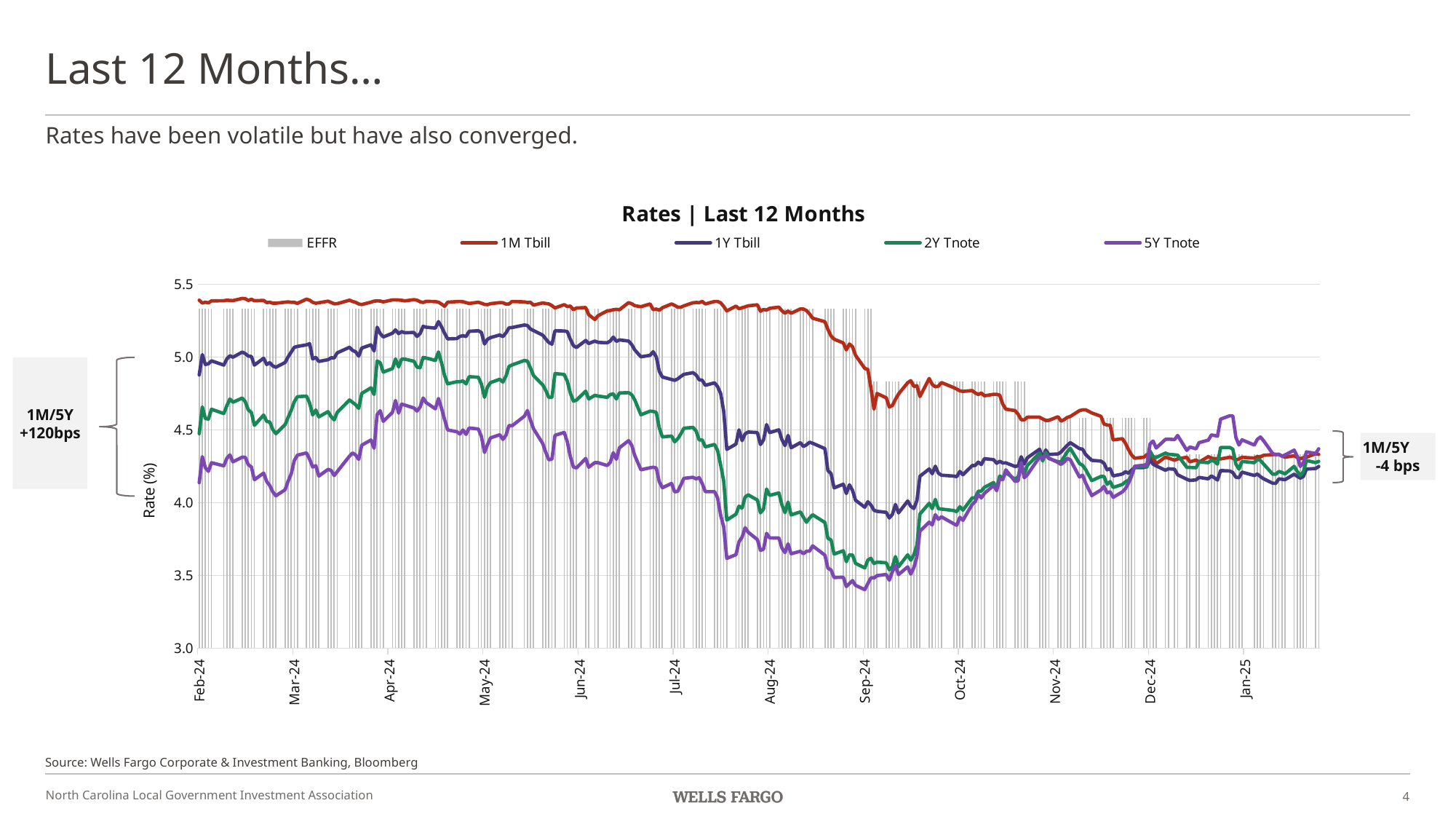
How many series does the legend of the 'Rates | Last 12 Months' chart list? 5 In Sep-24, which is higher: the 1M Tbill rate or the 5Y Tnote rate? 1M Tbill Is the 5Y Tnote rate in Feb-24 greater or less than 4.5? less What is the title of the chart? Rates | Last 12 Months Is the 1M Tbill rate in Feb-24 greater or less than 5.0? greater Does the 1M Tbill rate rise or fall over the period from Feb-24 to Jan-25? fall Which series has the lowest rate at the start of the chart in Feb-24? 5Y Tnote What type of chart is shown on the slide? combination bar and line chart According to the annotation on the right side of the chart, what is the 1M/5Y spread at the end of the period? -4 bps Is the lowest point of the 5Y Tnote line, around Sep-24, greater or less than 4.0? less Which series has the highest rate at the start of the chart in Feb-24? 1M Tbill What is the label on the vertical axis of the chart? Rate (%)